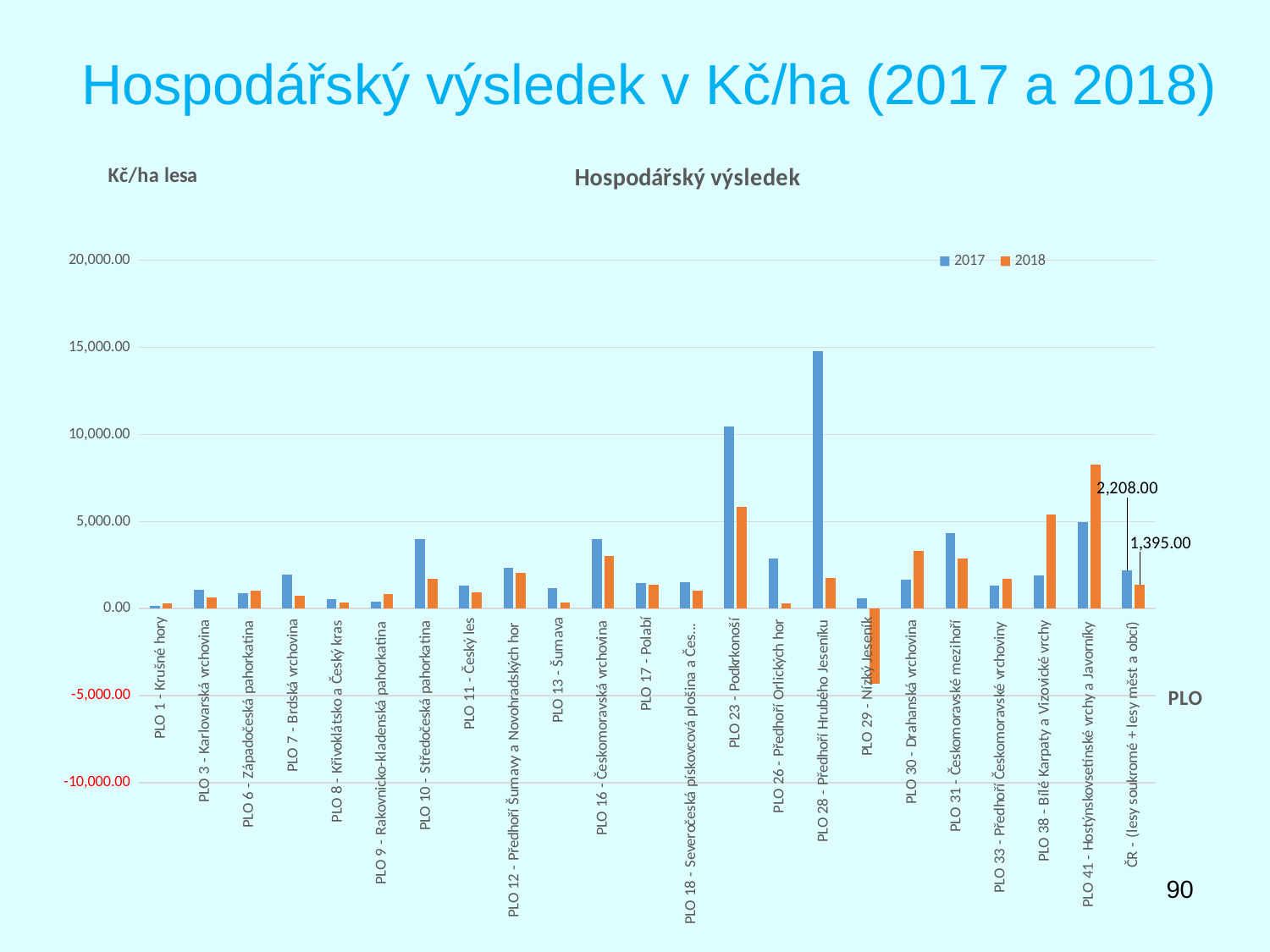
Which PLO has the lowest 2018 value? PLO 29 - Nízký Jeseník Which PLO has the highest 2017 value? PLO 28 - Předhoří Hrubého Jeseníku Is the 2017 value for PLO 28 - Předhoří Hrubého Jeseníku greater or less than 10,000.00? greater How many series does the legend list? 2 For PLO 41 - Hostýnskovsetínské vrchy a Javorníky, which year has the larger value, 2017 or 2018? 2018 What is the 2017 value for ČR - (lesy soukromé + lesy měst a obcí)? 2,208.00 Is the 2018 value for PLO 29 - Nízký Jeseník greater or less than 0.00? less What is the difference between the 2017 and 2018 values for ČR - (lesy soukromé + lesy měst a obcí)? 813.00 For PLO 23 - Podkrkonoší, which year has the larger value, 2017 or 2018? 2017 What is the 2018 value for ČR - (lesy soukromé + lesy měst a obcí)? 1,395.00 Which PLO has the highest 2018 value? PLO 41 - Hostýnskovsetínské vrchy a Javorníky What type of chart is shown on the slide? bar chart